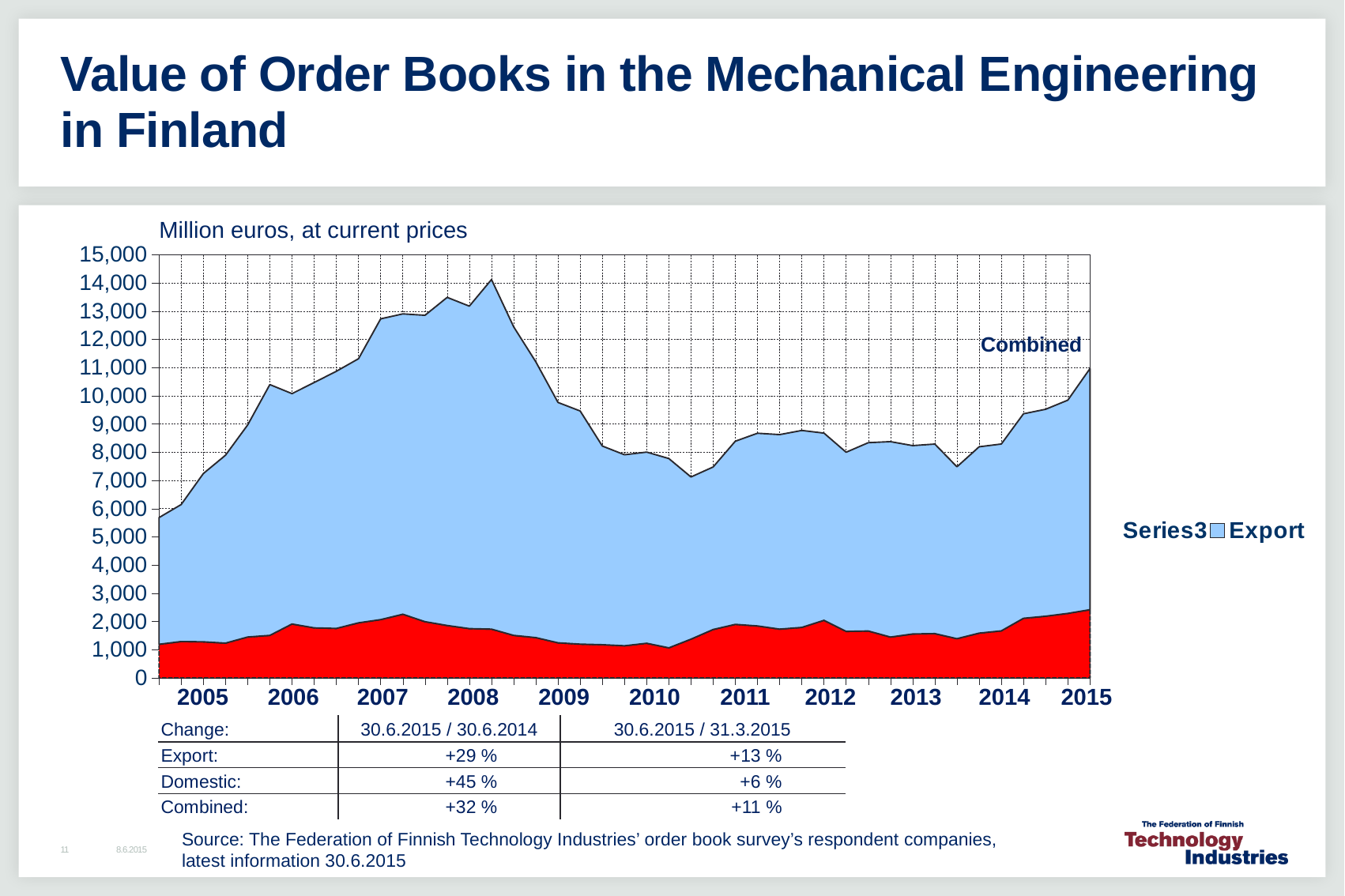
Does the combined value rise or fall between its 2008 peak and 2009? fall What unit label is shown above the chart's y axis? Million euros, at current prices Is the combined value at its lowest point in 2010 greater or less than 8,000? less How many years are labelled on the x axis of the chart? 11 How many series does the chart legend list? 2 Is the red (Series3) value at the end of 2015 greater or less than 2,000? greater What are the two entries in the chart legend? Series3 and Export Is the combined value at the end of the series in 2015 greater or less than 10,000? greater Does the combined value rise or fall from 2013 to 2015? rise What kind of chart is shown on the slide? Area chart